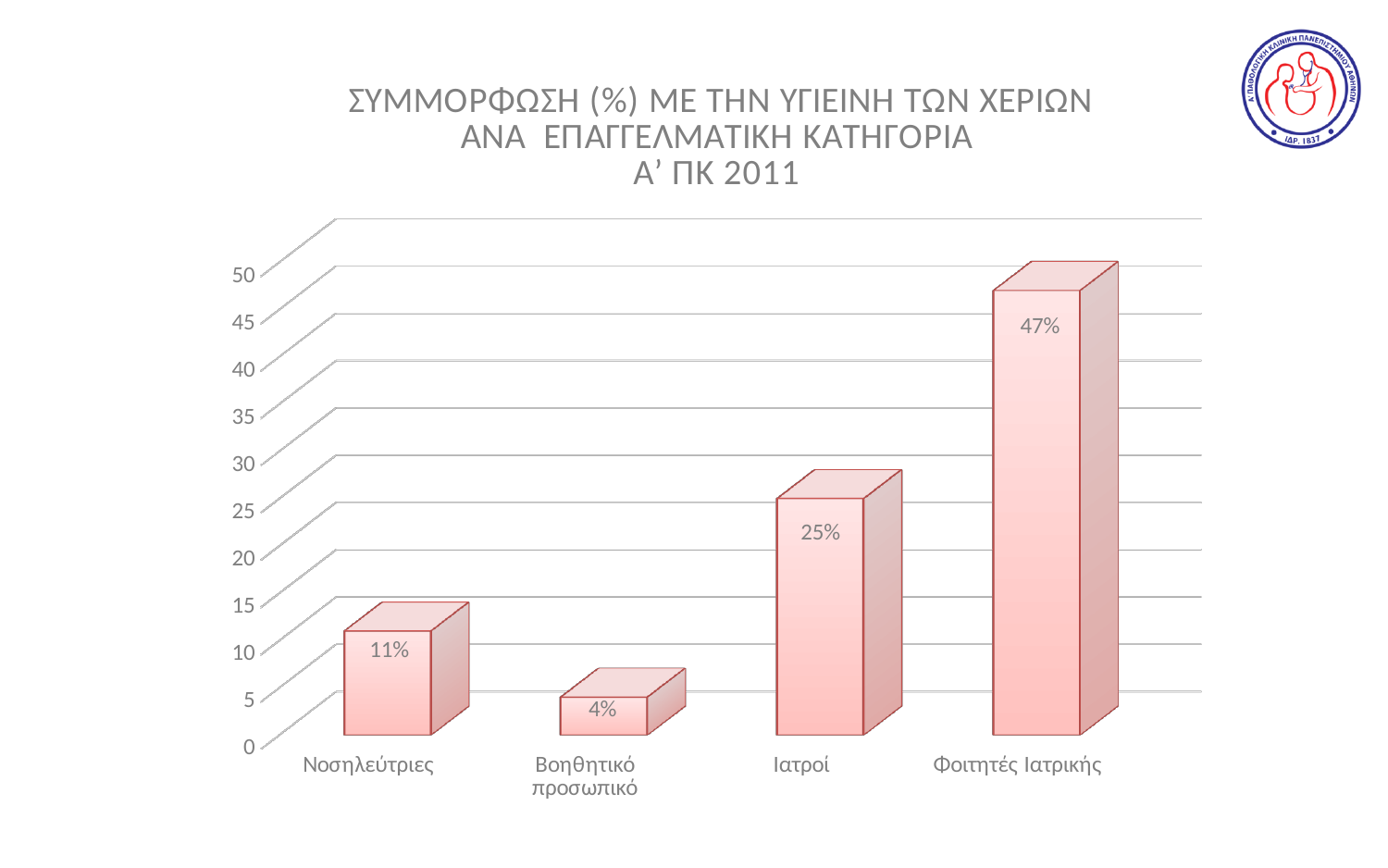
What is the difference between the values for Φοιτητές Ιατρικής and Ιατροί? 22% Which category has the highest value? Φοιτητές Ιατρικής What is the value for Ιατροί? 25% What is the title of the chart? ΣΥΜΜΟΡΦΩΣΗ (%) ΜΕ ΤΗΝ ΥΓΙΕΙΝΗ ΤΩΝ ΧΕΡΙΩΝ ΑΝΑ ΕΠΑΓΓΕΛΜΑΤΙΚΗ ΚΑΤΗΓΟΡΙΑ Α’ ΠΚ 2011 What is the value for Φοιτητές Ιατρικής? 47% What is the value for Νοσηλεύτριες? 11% What kind of chart is shown on the slide? Bar chart What is the difference between the values for Νοσηλεύτριες and Βοηθητικό προσωπικό? 7% Which category has the lowest value? Βοηθητικό προσωπικό What is the value for Βοηθητικό προσωπικό? 4% Which is larger, the value for Ιατροί or the value for Νοσηλεύτριες? Ιατροί How many categories are shown on the x axis? 4